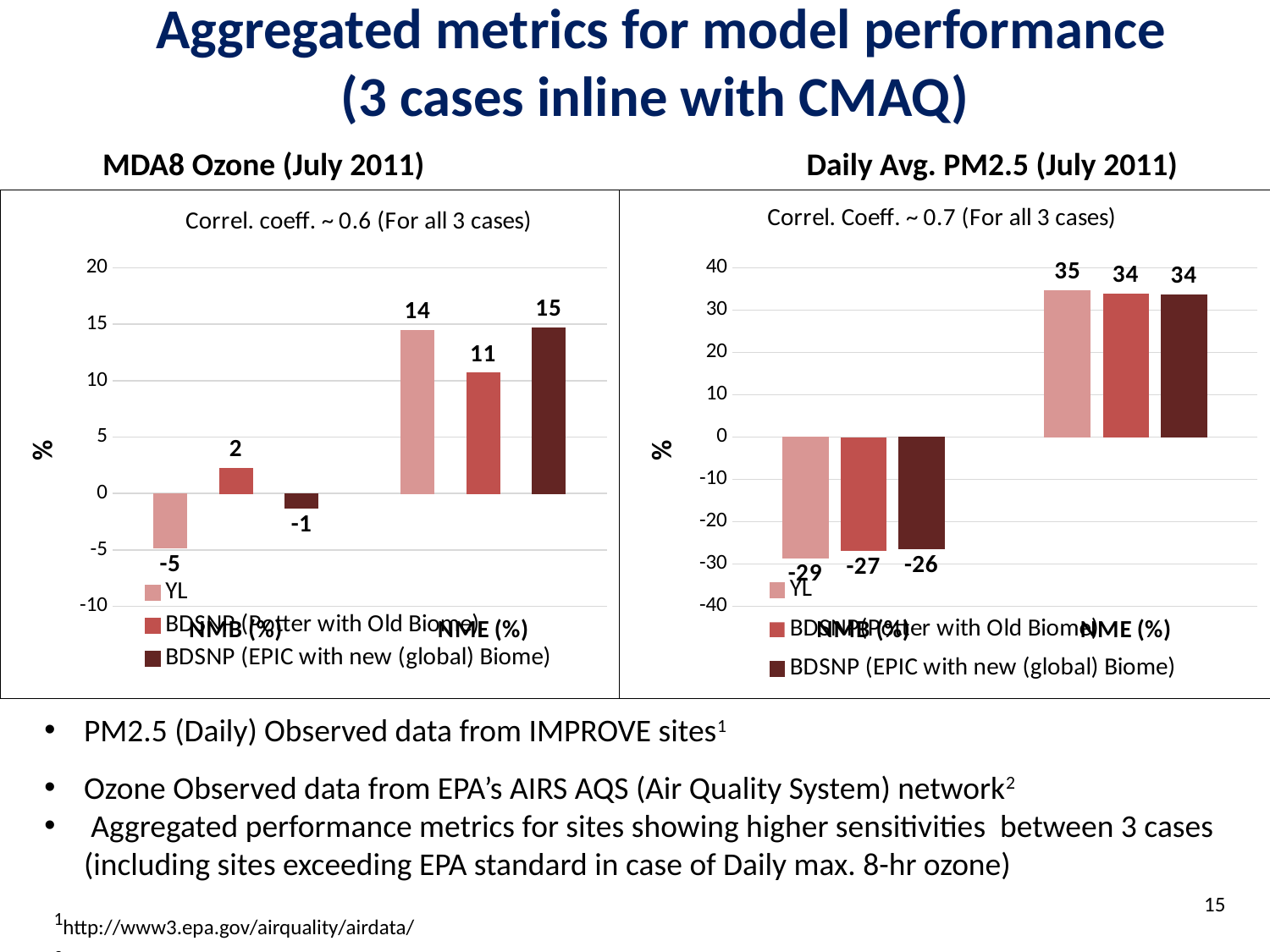
In the Daily Avg. PM2.5 (July 2011) chart, what is the NME (%) value for the YL series? 35 In the MDA8 Ozone (July 2011) chart, which is larger: the NME (%) value for YL or for BDSNP (Potter with Old Biome)? YL In the Daily Avg. PM2.5 (July 2011) chart, what is the NMB (%) value for the YL series? -29 In the Daily Avg. PM2.5 (July 2011) chart, is the NME (%) value for YL greater or less than 30? greater What correlation coefficient is stated in the title of the Daily Avg. PM2.5 (July 2011) chart? ~ 0.7 How many series does the legend of the Daily Avg. PM2.5 (July 2011) chart list? 3 In the MDA8 Ozone (July 2011) chart, which series has the highest NME (%) value? BDSNP (EPIC with new (global) Biome) What kind of chart is the MDA8 Ozone (July 2011) chart? Bar chart In the MDA8 Ozone (July 2011) chart, what is the NME (%) value for BDSNP (EPIC with new (global) Biome)? 15 In the MDA8 Ozone (July 2011) chart, what is the NMB (%) value for the YL series? -5 In the Daily Avg. PM2.5 (July 2011) chart, which series has the lowest NMB (%) value? YL In the MDA8 Ozone (July 2011) chart, what is the difference between the NME (%) values for YL and BDSNP (Potter with Old Biome)? 3